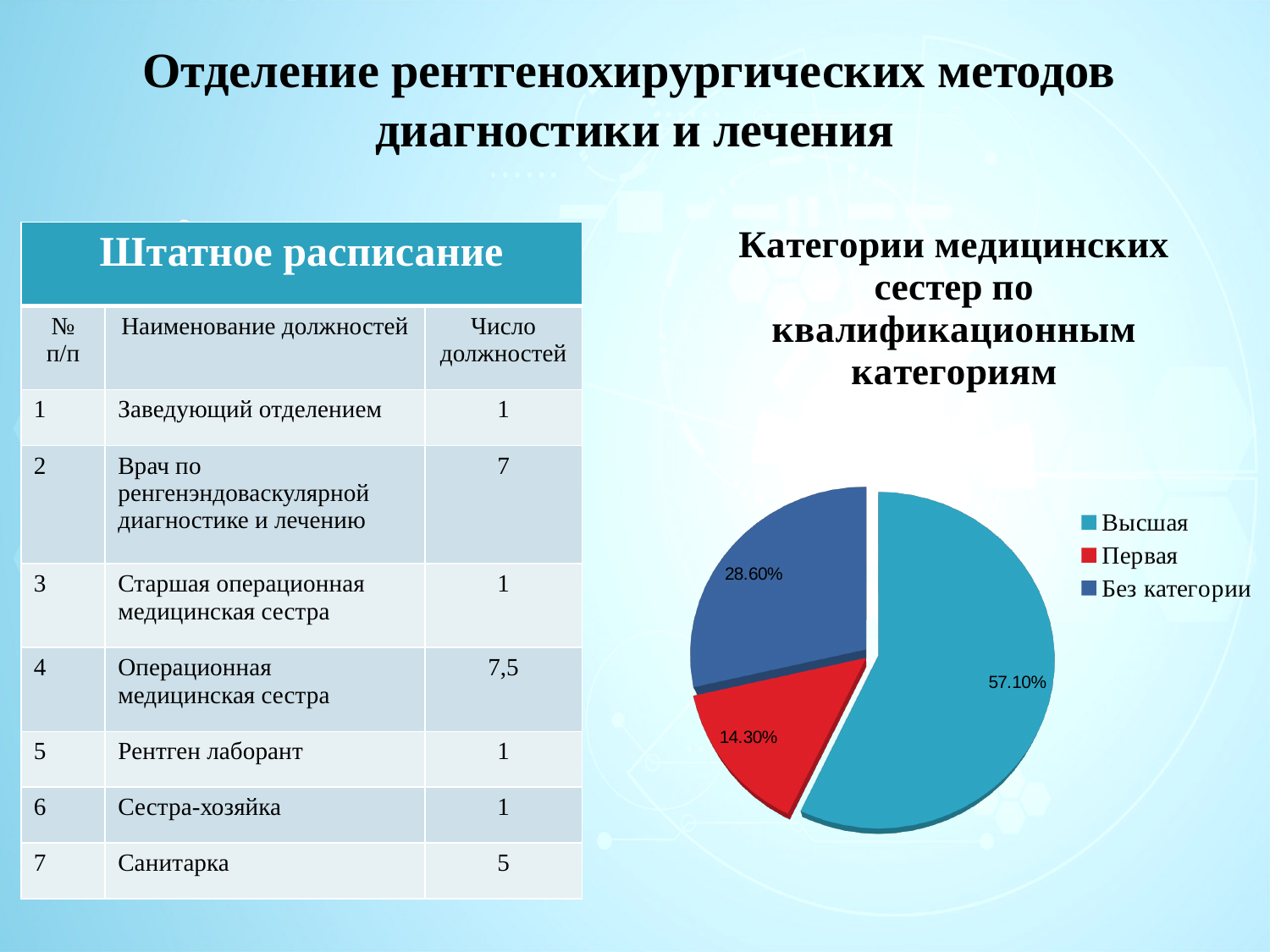
What colour is the "Первая" slice in the pie chart? red What kind of chart is shown on the slide? pie chart What is the title of the pie chart? Категории медицинских сестер по квалификационным категориям What share of the pie chart does the "Без категории" category have? 28.60% How many entries does the legend of the pie chart list? 3 What share of the pie chart does the "Первая" category have? 14.30% What is the difference between the shares of "Высшая" and "Без категории" in the pie chart? 28.50% Which is larger in the pie chart, the share of "Без категории" or the share of "Первая"? Без категории Which category has the smallest slice in the pie chart? Первая How many categories does the pie chart show? 3 What share of the pie chart does the "Высшая" category have? 57.10% Which category has the largest slice in the pie chart? Высшая